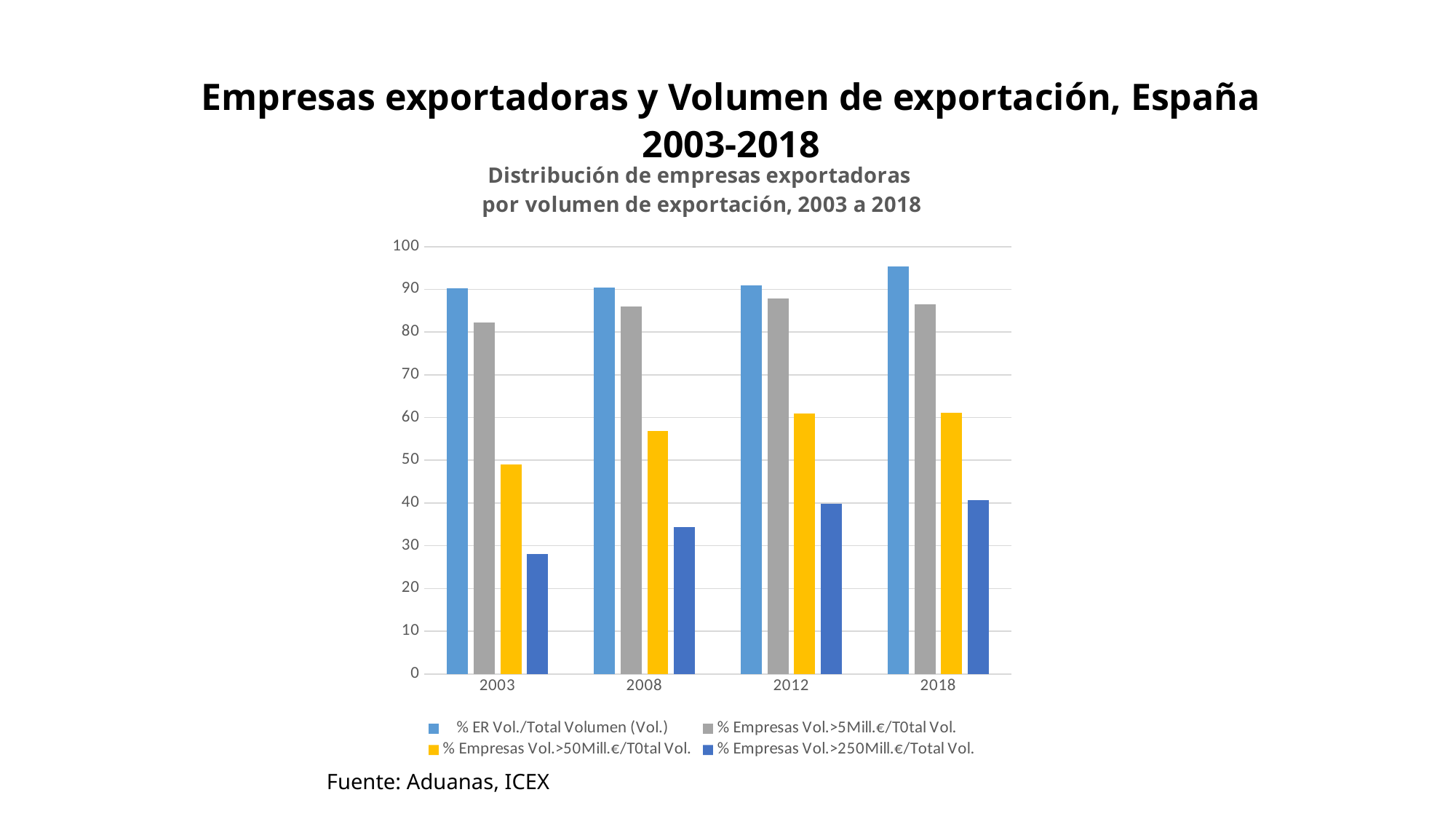
Is the value for '% Empresas Vol.>250Mill.€/Total Vol.' in 2003 greater or less than 40? less How many years are shown on the x axis of the chart? 4 Does the value for '% Empresas Vol.>250Mill.€/Total Vol.' rise or fall from 2003 to 2018? rise What colour represents '% Empresas Vol.>50Mill.€/T0tal Vol.' in the chart? yellow Is the value for '% ER Vol./Total Volumen (Vol.)' in 2018 greater or less than 90? greater Is the value for '% Empresas Vol.>50Mill.€/T0tal Vol.' in 2003 greater or less than 60? less How many series does the chart legend list? 4 In which year is the bar for '% ER Vol./Total Volumen (Vol.)' the highest? 2018 In which year is the bar for '% Empresas Vol.>250Mill.€/Total Vol.' the lowest? 2003 In 2003, which is larger: '% Empresas Vol.>5Mill.€/T0tal Vol.' or '% Empresas Vol.>50Mill.€/T0tal Vol.'? % Empresas Vol.>5Mill.€/T0tal Vol. What kind of chart is shown on the slide? bar chart